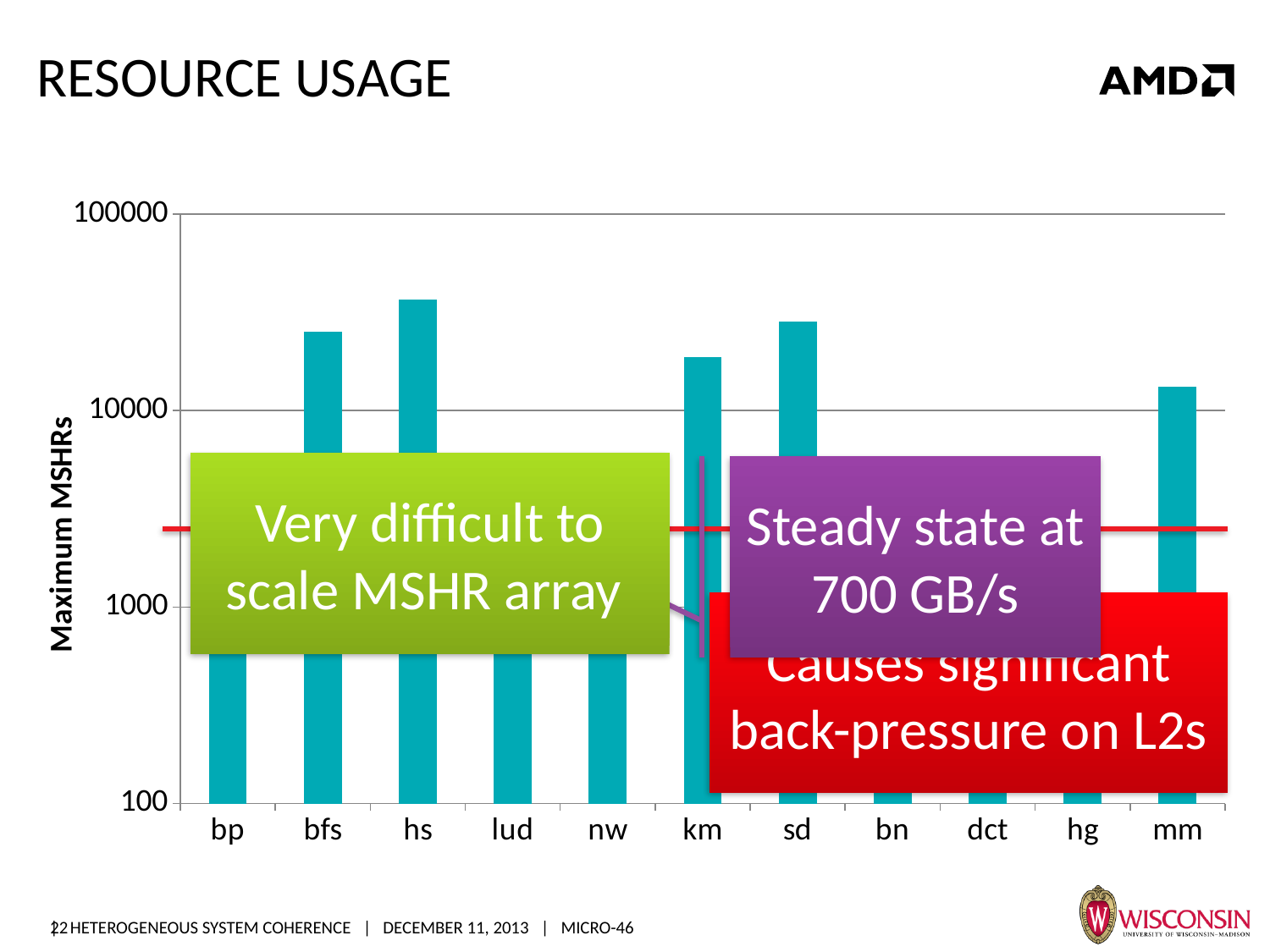
What is the title of the slide containing the chart? RESOURCE USAGE What is the label of the y axis of the chart? Maximum MSHRs Is the value for hs greater or less than 10000? greater Is the value for km greater or less than 100000? less What kind of chart is shown on the slide? bar chart Which has a larger value, km or mm? km How many categories are shown on the x axis of the chart? 11 Is the value for bfs greater or less than 10000? greater Which category has the highest Maximum MSHRs value? hs Which has a larger value, hs or sd? hs